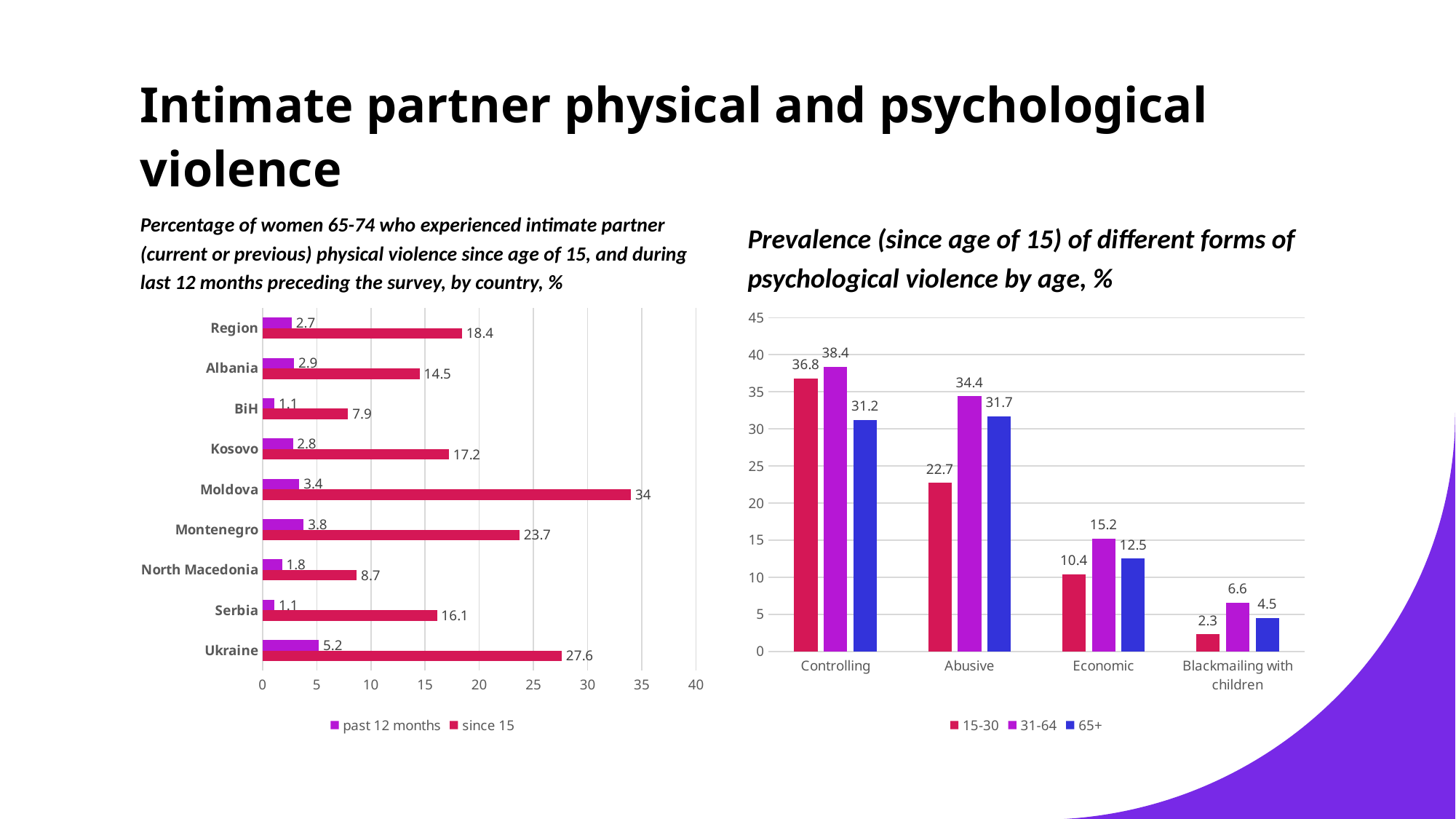
In the left chart, what is the difference between the 'since 15' values for Montenegro and Albania? 9.2 In the left chart, what is the 'since 15' value for Moldova? 34 What type of chart is the right chart? Bar chart In the left chart, how many series does the legend list? 2 In the right chart, which is larger for Economic violence: the 15-30 value or the 65+ value? 65+ In the left chart, which category has the lowest 'since 15' value? BiH In the right chart, what is the value for the 31-64 group for Abusive violence? 34.4 In the right chart, what is the difference between the 31-64 and 15-30 values for Controlling violence? 1.6 In the left chart, what is the 'past 12 months' value for Ukraine? 5.2 In the right chart, which form of psychological violence has the lowest value for the 15-30 group? Blackmailing with children In the left chart, which country has the highest 'since 15' value? Moldova In the left chart, how many categories are shown on the vertical axis? 9